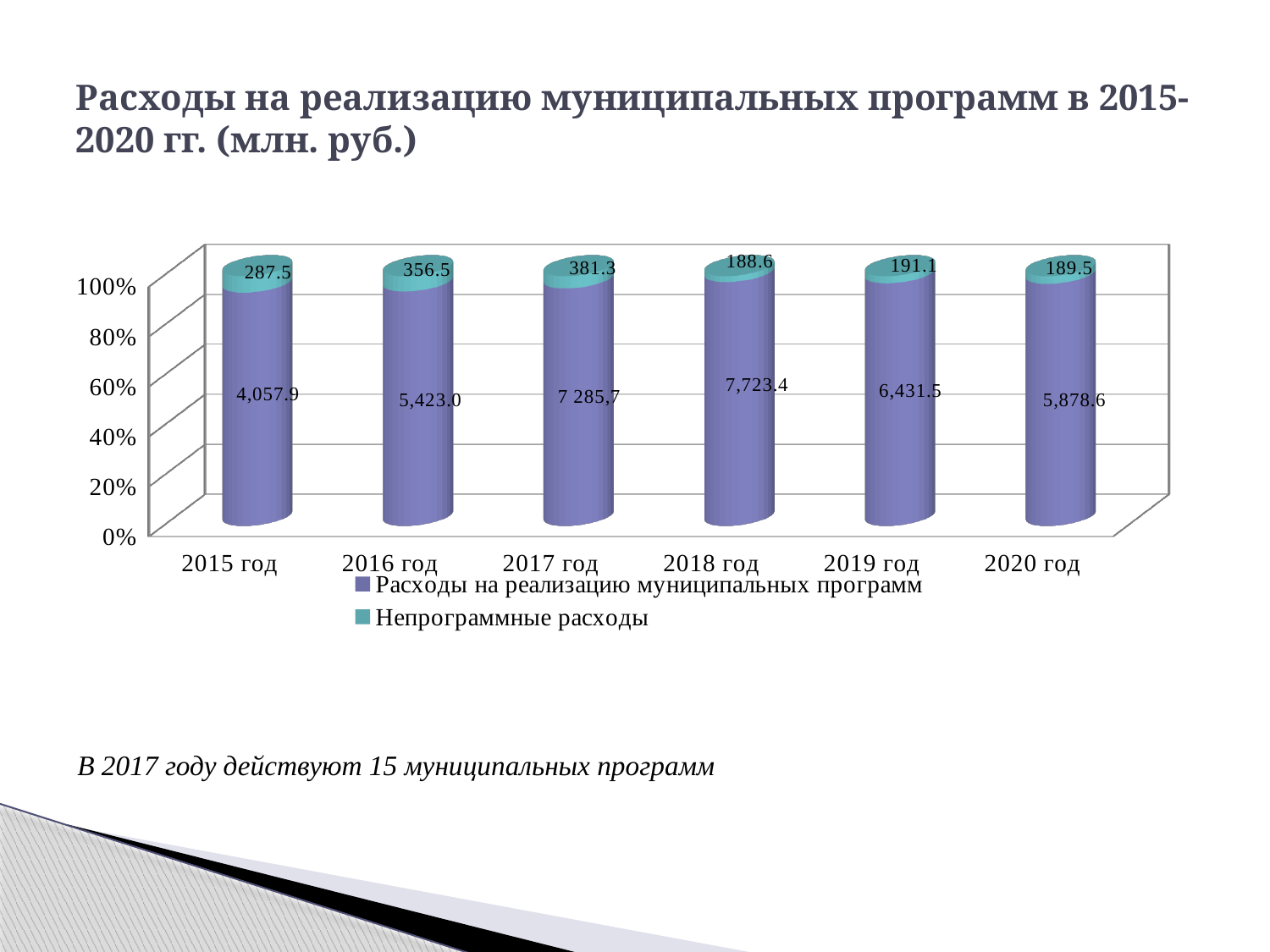
What is the value of 'Непрограммные расходы' for 2017 год? 381.3 What is the value of 'Расходы на реализацию муниципальных программ' for 2015 год? 4,057.9 How many series does the legend list? 2 What is the difference between 'Расходы на реализацию муниципальных программ' in 2018 год and in 2015 год? 3,665.5 Which is larger: 'Расходы на реализацию муниципальных программ' in 2019 год or in 2016 год? 2019 год What kind of chart is shown on the slide? Stacked bar chart In which year is 'Непрограммные расходы' the lowest? 2018 год In which year is 'Расходы на реализацию муниципальных программ' the highest? 2018 год What is the difference between 'Непрограммные расходы' in 2017 год and in 2018 год? 192.7 Do the values of 'Расходы на реализацию муниципальных программ' rise or fall from 2015 год to 2018 год? Rise How many years are shown on the x axis? 6 What is the value of 'Расходы на реализацию муниципальных программ' for 2020 год? 5,878.6